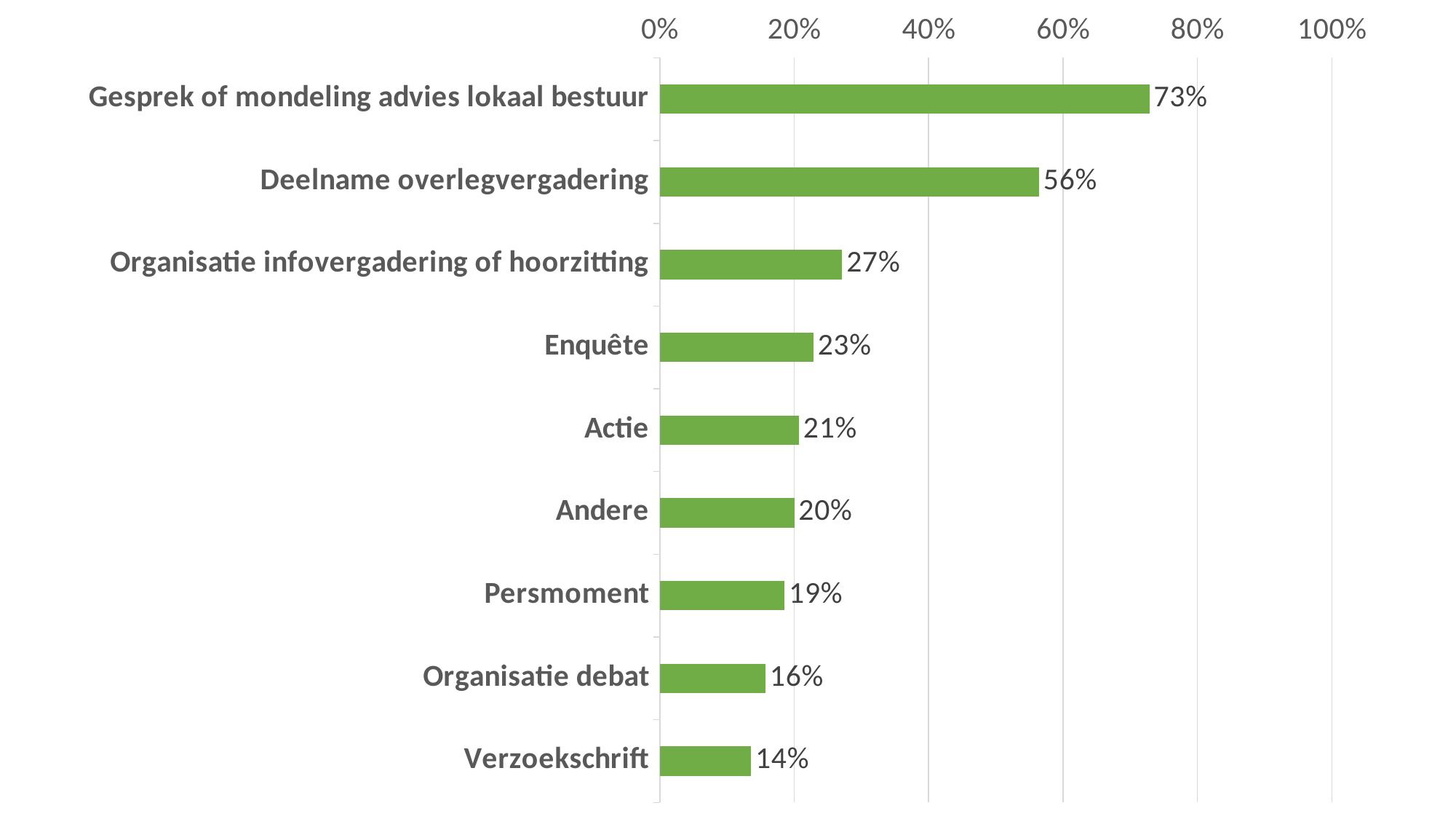
Is the value for Deelname overlegvergadering greater or less than 40%? greater What is the difference between the values for Organisatie infovergadering of hoorzitting and Verzoekschrift? 13% What is the value for Enquête? 23% What kind of chart is shown on the slide? Bar chart How many categories are shown in the chart? 9 What colour are the bars in the chart? Green What is the value for Organisatie debat? 16% Which category has the highest value? Gesprek of mondeling advies lokaal bestuur What is the value for Gesprek of mondeling advies lokaal bestuur? 73% Which category has the lowest value? Verzoekschrift What is the difference between the values for Gesprek of mondeling advies lokaal bestuur and Deelname overlegvergadering? 17% Which is larger, the value for Actie or the value for Persmoment? Actie